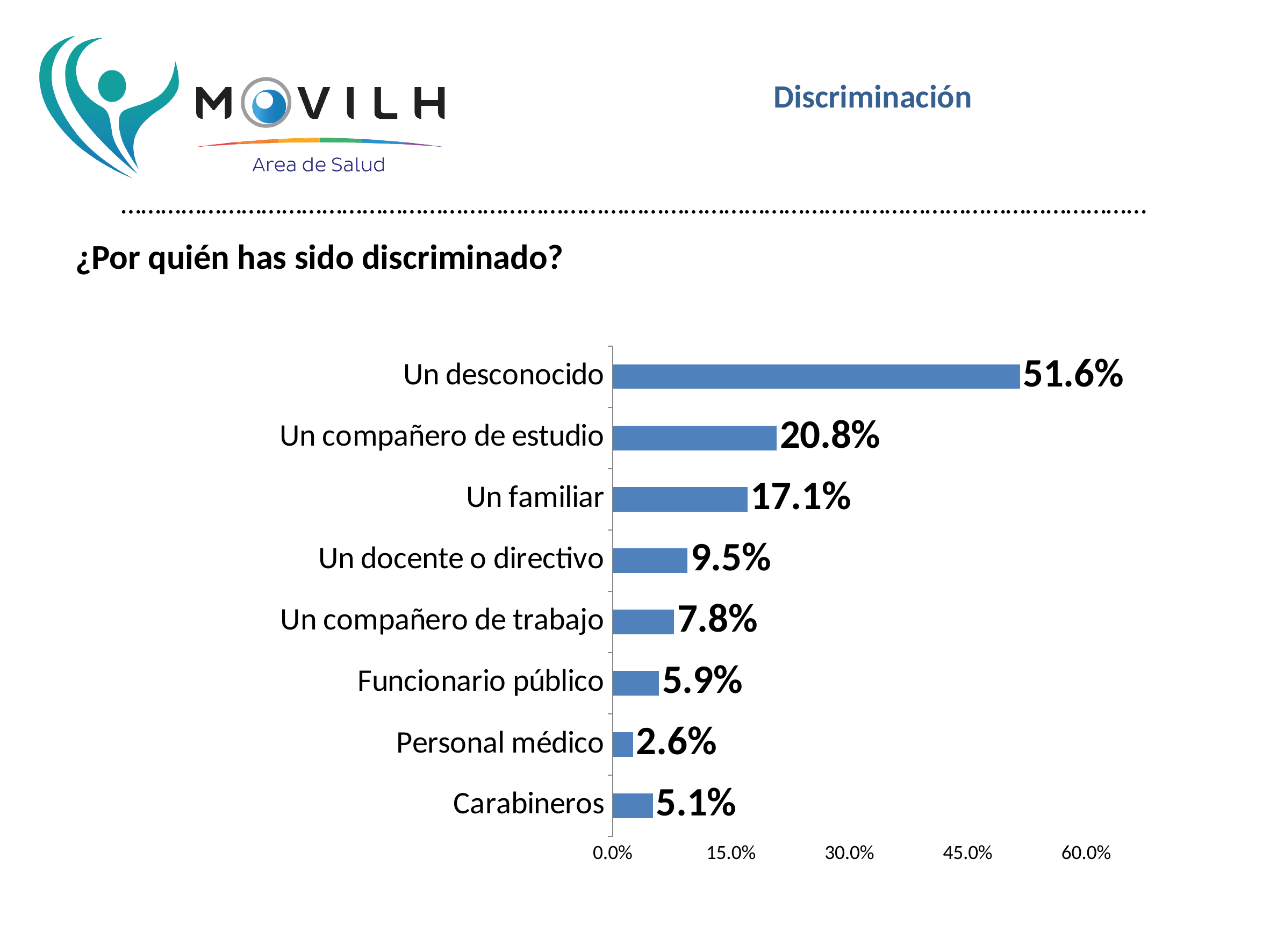
What is the value for "Un desconocido"? 51.6% What is the value for "Un familiar"? 17.1% How many categories are shown in the chart? 8 What question does the chart answer, as written above it? ¿Por quién has sido discriminado? Which category has the highest value? Un desconocido What is the difference between the values for "Un compañero de estudio" and "Un familiar"? 3.7% What is the value for "Carabineros"? 5.1% Is the value for "Un compañero de estudio" greater or less than 15.0%? greater What kind of chart is shown on the slide? Bar chart Which category has the lowest value? Personal médico What is the value for "Personal médico"? 2.6% Which is larger, the value for "Un docente o directivo" or the value for "Un compañero de trabajo"? Un docente o directivo